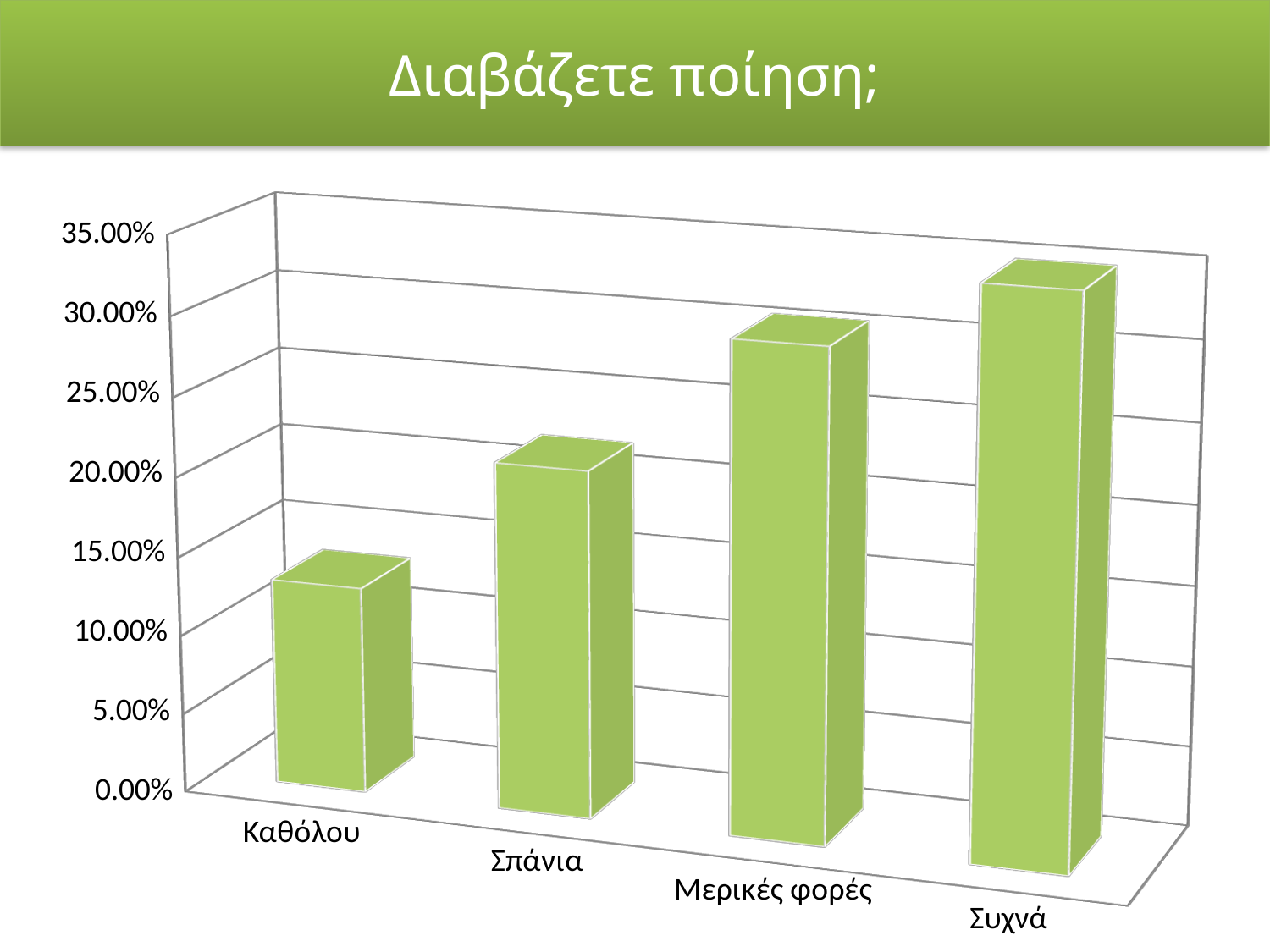
How many categories are shown on the x axis? 4 Is the value for Σπάνια greater or less than 15.00%? greater Is the value for Καθόλου greater or less than 20.00%? less Which is larger, the value for Σπάνια or the value for Μερικές φορές? Μερικές φορές Is the value for Συχνά greater or less than 25.00%? greater Which category has the lowest value? Καθόλου Which is larger, the value for Καθόλου or the value for Συχνά? Συχνά What is the title of the chart? Διαβάζετε ποίηση; What kind of chart is shown on the slide? bar chart Do the values rise or fall from left to right along the x axis? rise Which category has the highest value? Συχνά